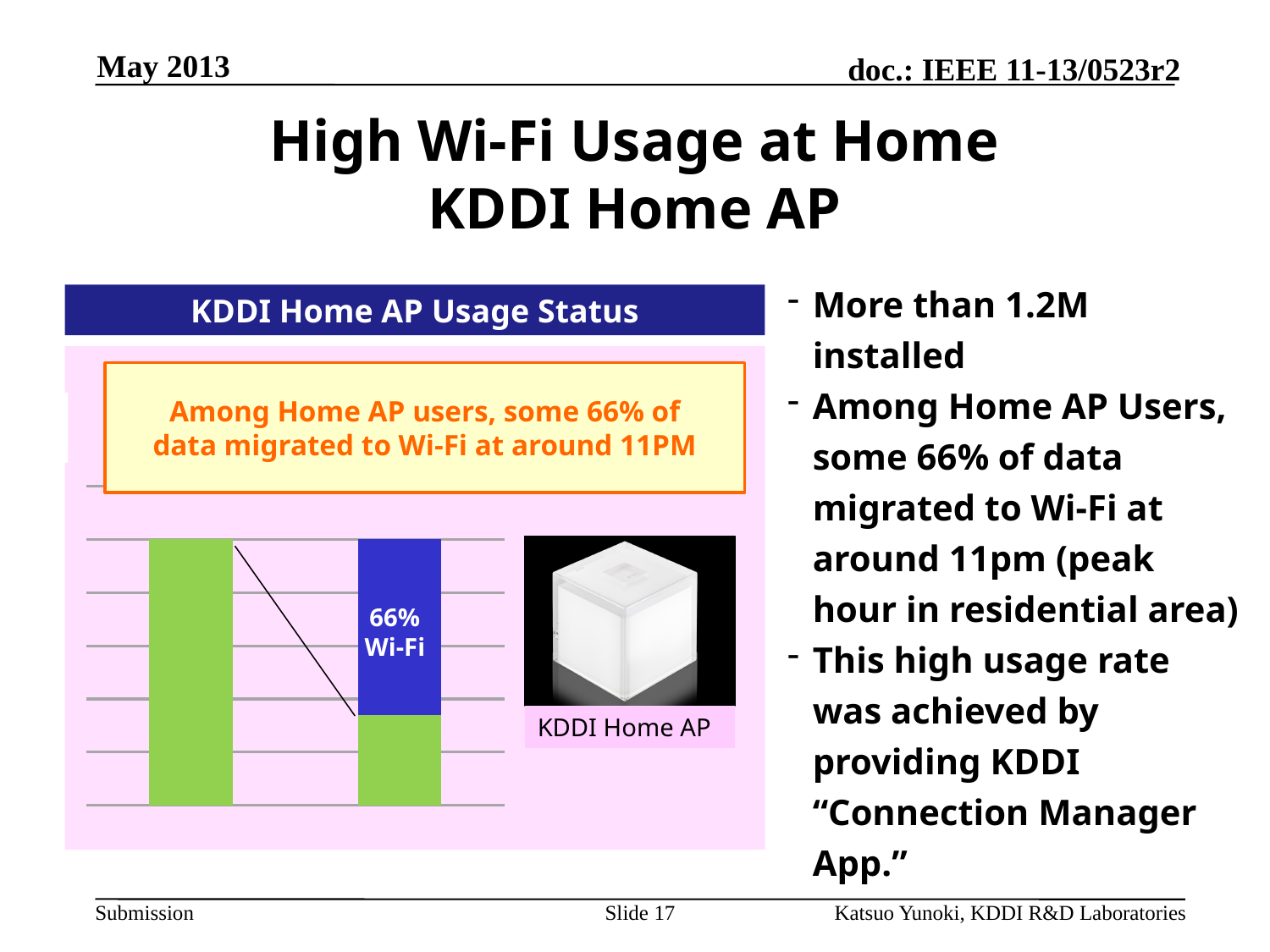
How many segments make up the right-hand bar in the "KDDI Home AP Usage Status" chart? 2 In the "KDDI Home AP Usage Status" chart, which segment of the right-hand bar is larger, the blue Wi-Fi segment or the green segment? the blue Wi-Fi segment What colour is the segment labelled "66% Wi-Fi" in the bar chart? blue In the "KDDI Home AP Usage Status" chart, what percentage of the right-hand bar is labelled as Wi-Fi? 66% How many bars are plotted in the "KDDI Home AP Usage Status" chart? 2 What is the title shown above the bar chart on the slide? KDDI Home AP Usage Status What kind of chart is shown under the heading "KDDI Home AP Usage Status"? bar chart